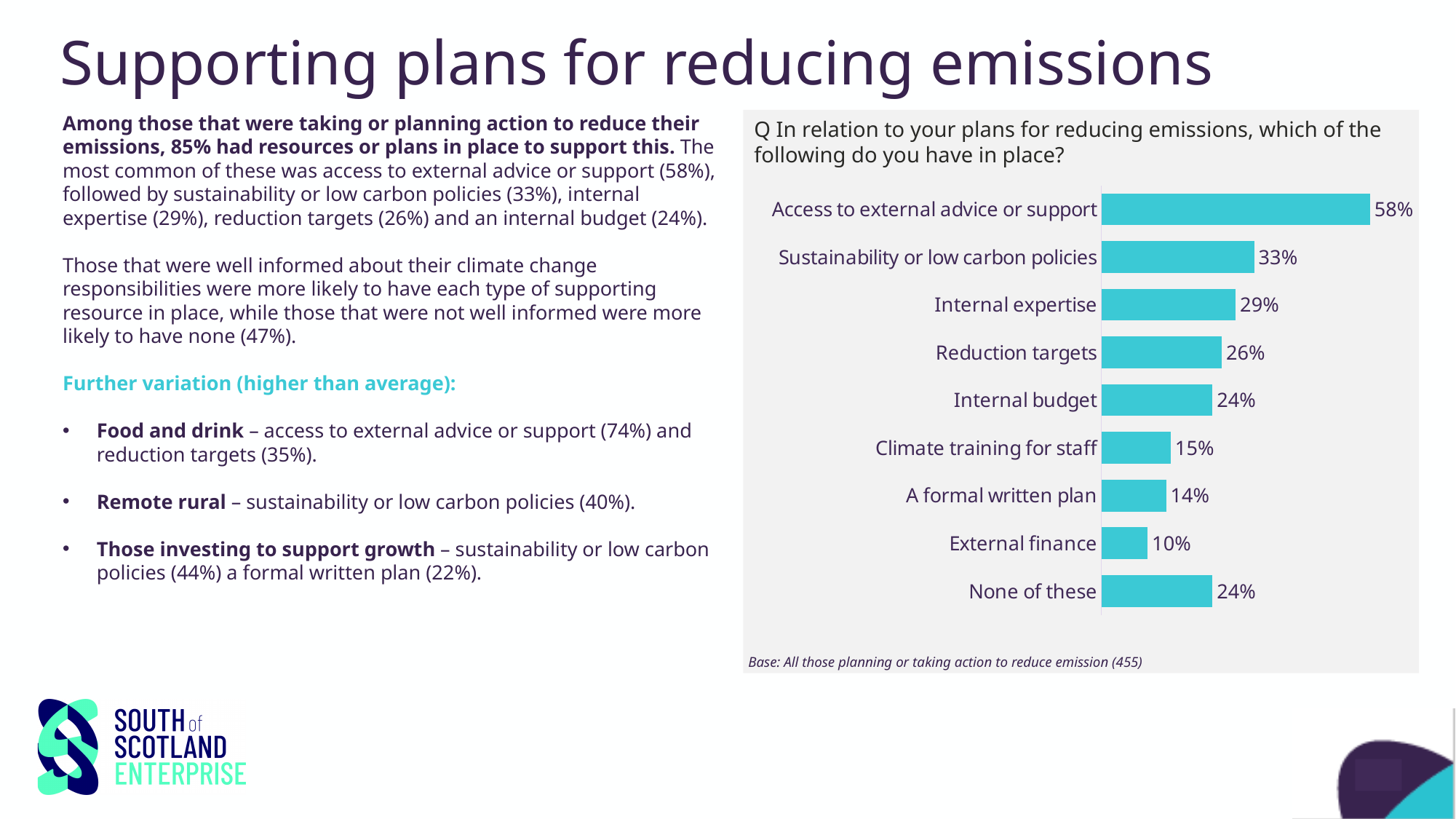
Which is larger: the value for Internal expertise or the value for Reduction targets? Internal expertise What type of chart is shown on the slide? Bar chart What colour are the bars in the chart? Teal How many categories are shown in the chart? 9 What is the base stated beneath the chart? All those planning or taking action to reduce emission (455) Which category has the highest value in the chart? Access to external advice or support What is the difference between the values for Access to external advice or support and Sustainability or low carbon policies? 25 percentage points What is the value shown for Internal budget? 24% What percentage of respondents have access to external advice or support in place? 58% What is the difference between the values for Climate training for staff and External finance? 5 percentage points What percentage have a formal written plan in place? 14% Which category has the lowest value in the chart? External finance